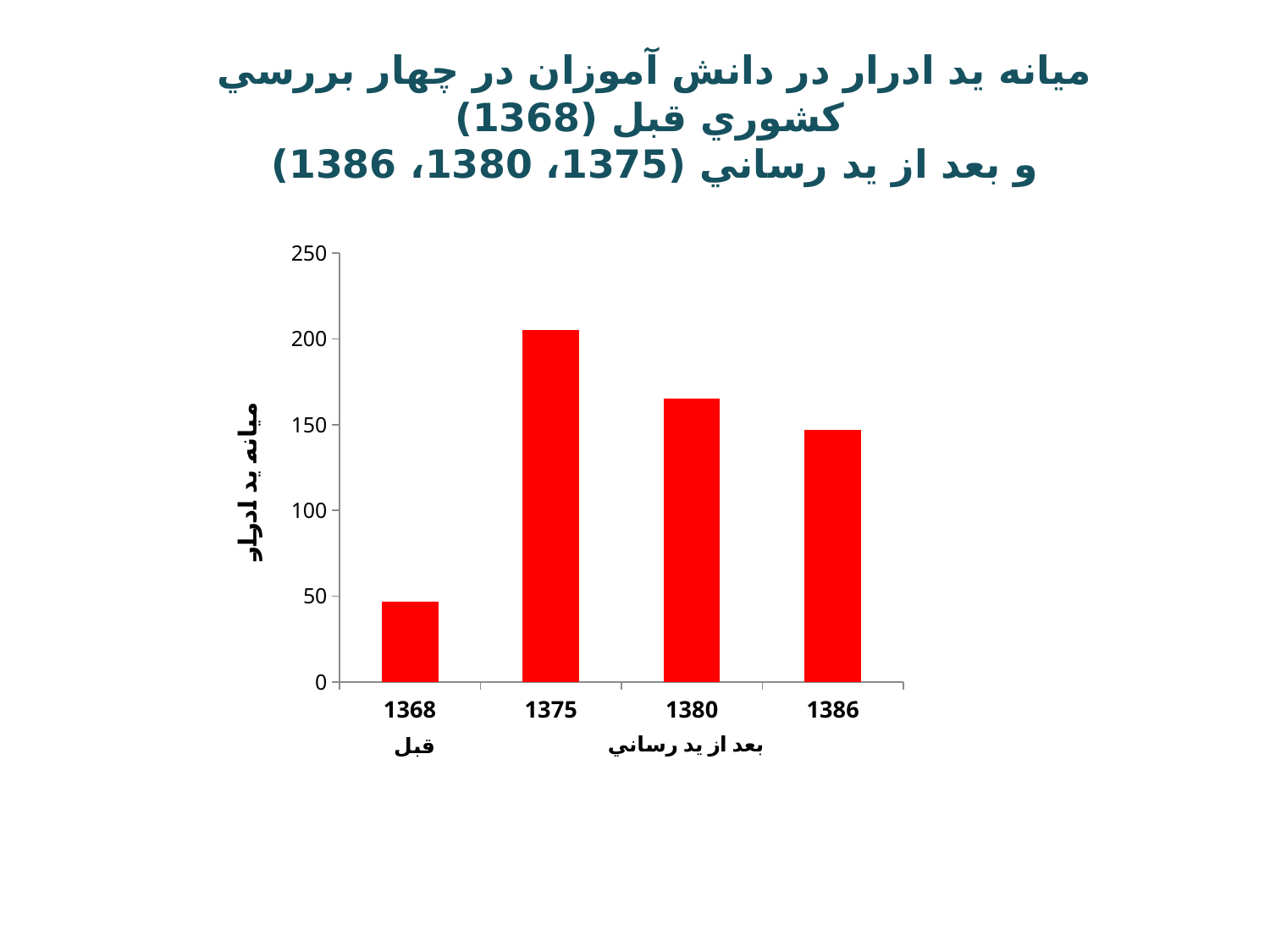
What colour are the bars in the chart? red Which year has the highest median urinary iodine value in the chart? 1375 Is the value for 1368 greater or less than 100? less How many bars (years) are plotted in the chart? 4 Is the value for 1386 greater or less than 200? less Across the three post-iodization years (1375, 1380, 1386), do the values rise or fall from left to right? fall What kind of chart is shown on the slide? bar chart Which has the larger value, 1368 or 1386? 1386 Is the value for 1380 greater or less than 150? greater Which year has the lowest median urinary iodine value in the chart? 1368 Which has the larger value, 1380 or 1386? 1380